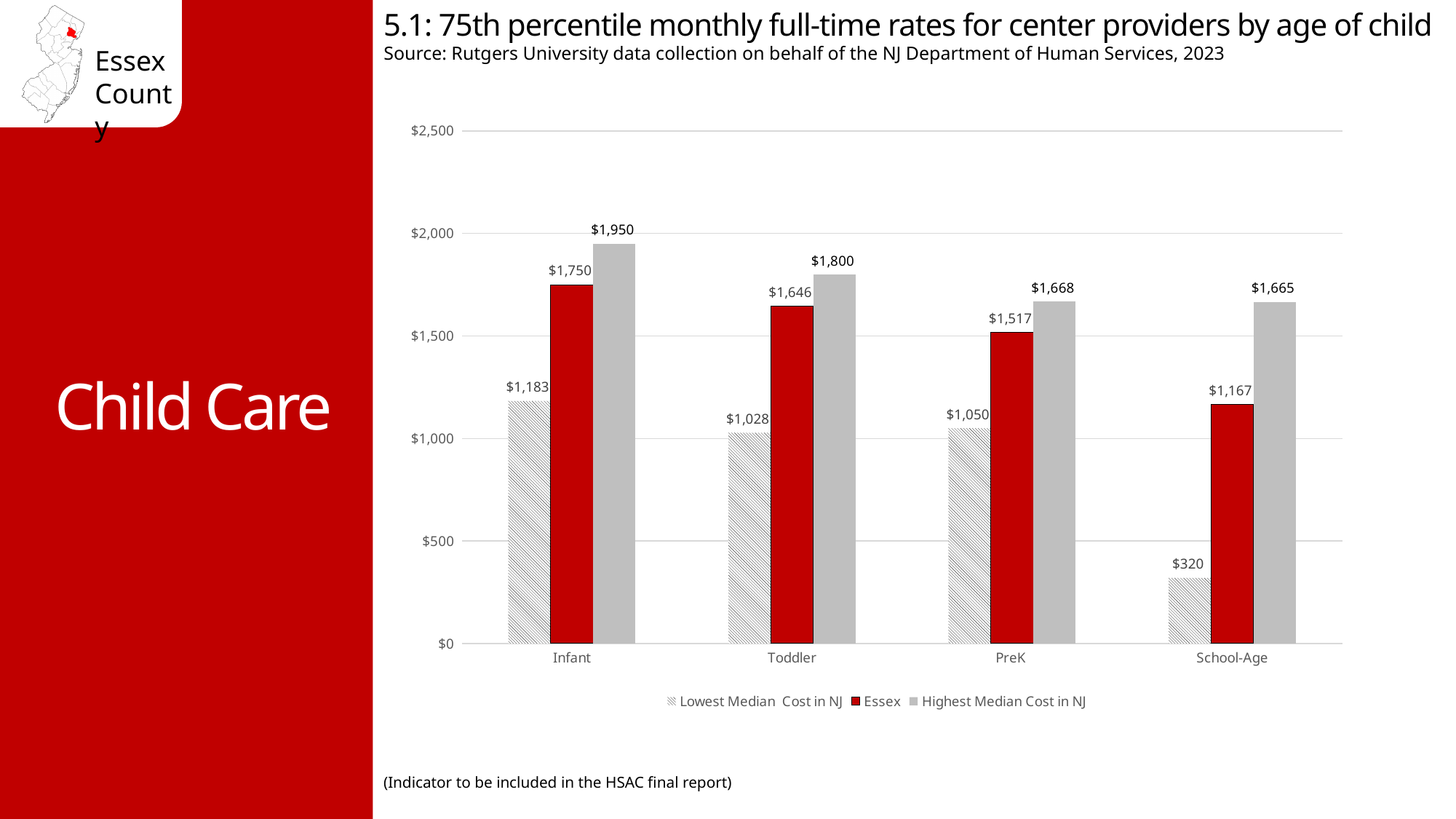
Which age group has the highest Essex value? Infant How many series does the legend list? 3 Do the Essex values rise or fall from Infant to School-Age? Fall What kind of chart is shown on the slide? Bar chart What is the Highest Median Cost in NJ for Toddler? $1,800 Which age group has the lowest Lowest Median Cost in NJ value? School-Age What is the difference between the Highest Median Cost in NJ and the Essex value for Infant? $200 How many age groups are shown on the x axis? 4 Which is larger for School-Age: the Essex value or the Lowest Median Cost in NJ value? Essex What is the Lowest Median Cost in NJ for School-Age? $320 What is the Essex value for Infant? $1,750 What is the Essex value for PreK? $1,517